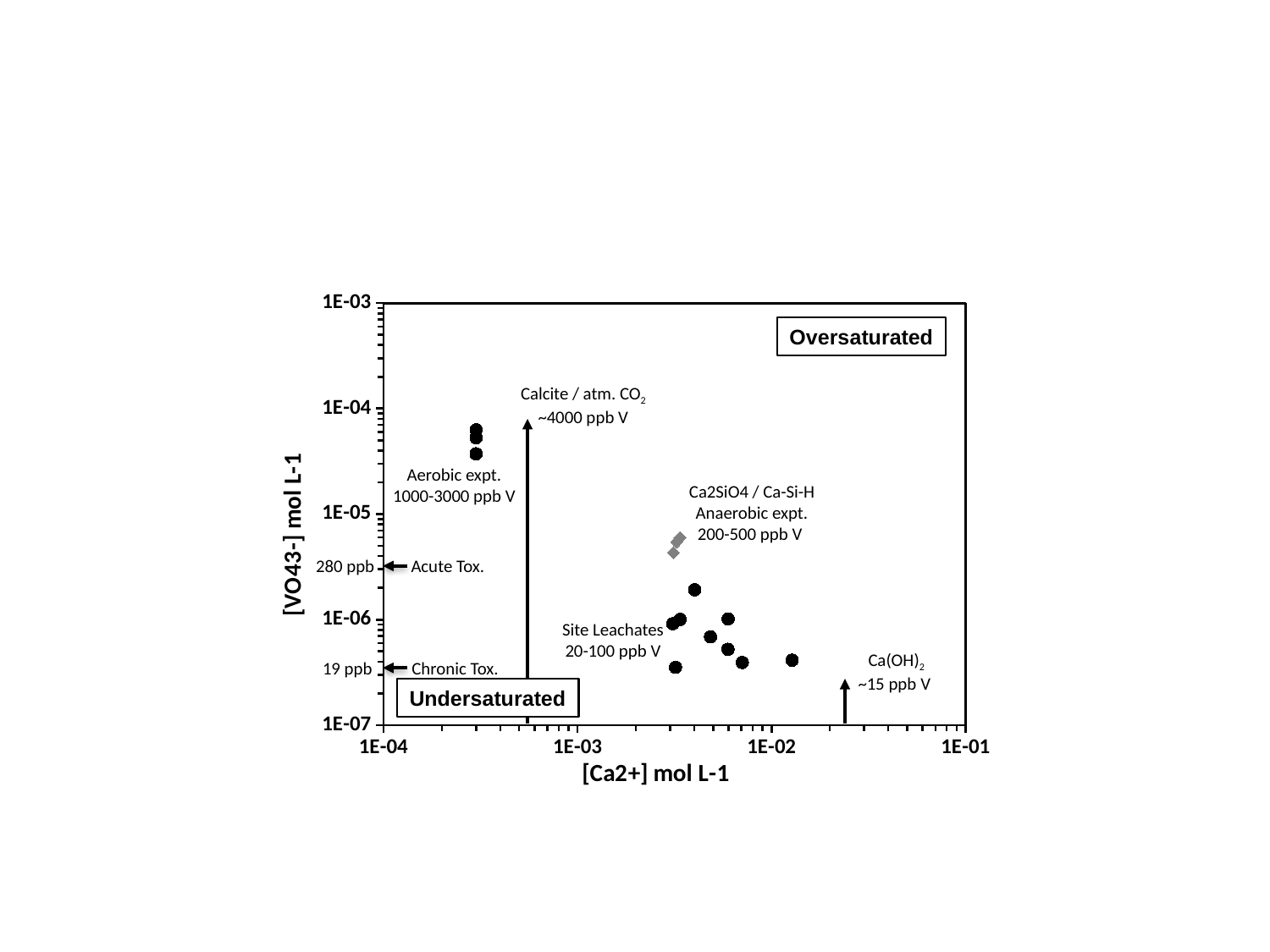
What vanadium concentration range is given for the Site Leachates? 20-100 ppb V What vanadium concentration is marked for the Acute Tox. line? 280 ppb What is the label of the y axis? [VO43-] mol L-1 What vanadium concentration range is given for the Aerobic expt. points? 1000-3000 ppb V Which group has higher [VO43-] values, the Aerobic expt. points or the Site Leachates? Aerobic expt. What vanadium concentration is marked for the Chronic Tox. line? 19 ppb Is the [Ca2+] value for the Aerobic expt. points greater or less than 1E-03? less What approximate vanadium concentration is given for the Ca(OH)2 line? ~15 ppb V What is the label of the x axis? [Ca2+] mol L-1 What kind of chart is shown on the slide? scatter plot What approximate vanadium concentration is given for the Calcite / atm. CO2 line? ~4000 ppb V Is the [VO43-] value for the Aerobic expt. points greater or less than 1E-05? greater